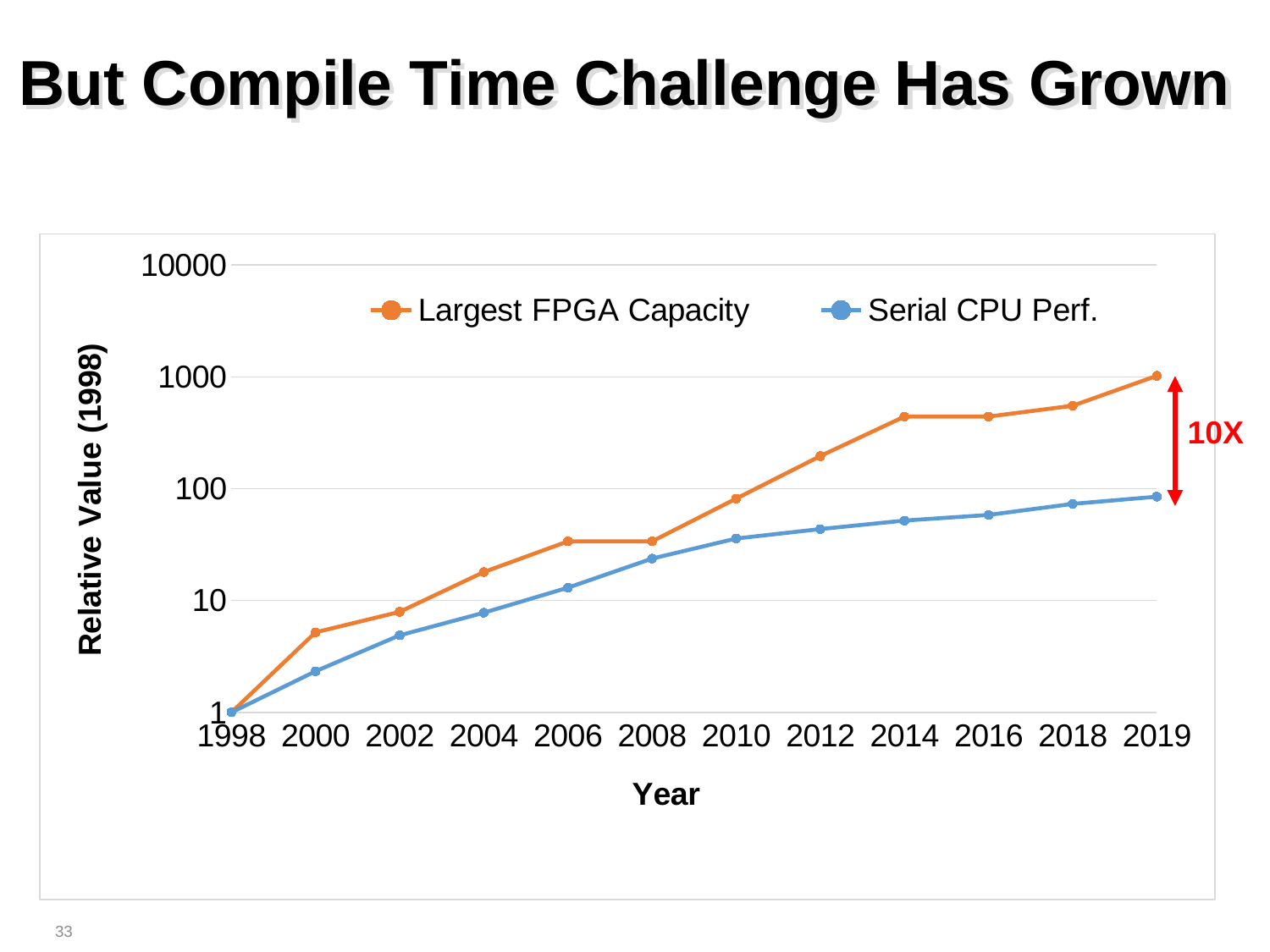
In 2006, which series has the larger value, Largest FPGA Capacity or Serial CPU Perf.? Largest FPGA Capacity What is the value of Serial CPU Perf. in 1998? 1 Is the value for Serial CPU Perf. in 2008 greater or less than 100? less How many series does the legend list? 2 Is the value for Largest FPGA Capacity in 2014 greater or less than 100? greater In which year is Largest FPGA Capacity at its highest? 2019 Is the value for Serial CPU Perf. in 2002 greater or less than 10? less How many years are marked along the x axis? 12 What kind of chart is shown on the slide? line chart Does the Largest FPGA Capacity series rise or fall from 1998 to 2019? rise What is the label on the y axis? Relative Value (1998) In 2019, which series has the larger value, Largest FPGA Capacity or Serial CPU Perf.? Largest FPGA Capacity